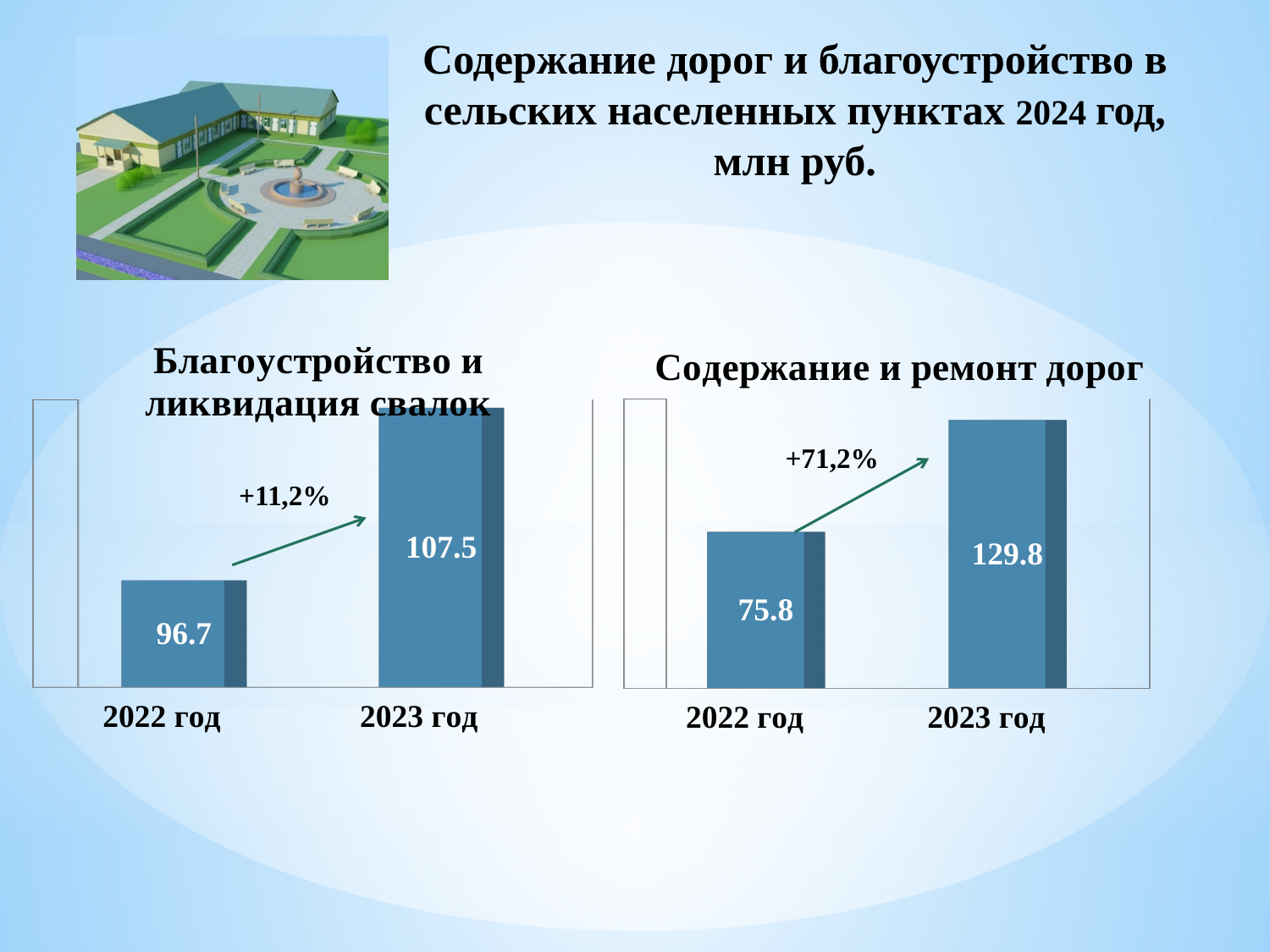
In the chart titled "Благоустройство и ликвидация свалок", which year has the lowest value? 2022 год In the chart titled "Благоустройство и ликвидация свалок", what is the value for 2023 год? 107.5 In the chart titled "Содержание и ремонт дорог", what percentage change is annotated between 2022 год and 2023 год? +71,2% In the chart titled "Содержание и ремонт дорог", which is larger: the value for 2022 год or 2023 год? 2023 год In the chart titled "Содержание и ремонт дорог", what is the difference between the 2023 год and 2022 год values? 54.0 In the chart titled "Благоустройство и ликвидация свалок", what is the value for 2022 год? 96.7 How many bars are shown in the chart titled "Благоустройство и ликвидация свалок"? 2 In the chart titled "Содержание и ремонт дорог", what is the value for 2023 год? 129.8 What type of chart is the chart titled "Содержание и ремонт дорог"? Bar chart In the chart titled "Благоустройство и ликвидация свалок", what is the difference between the 2023 год and 2022 год values? 10.8 In the chart titled "Содержание и ремонт дорог", what is the value for 2022 год? 75.8 In the chart titled "Содержание и ремонт дорог", which year has the highest value? 2023 год